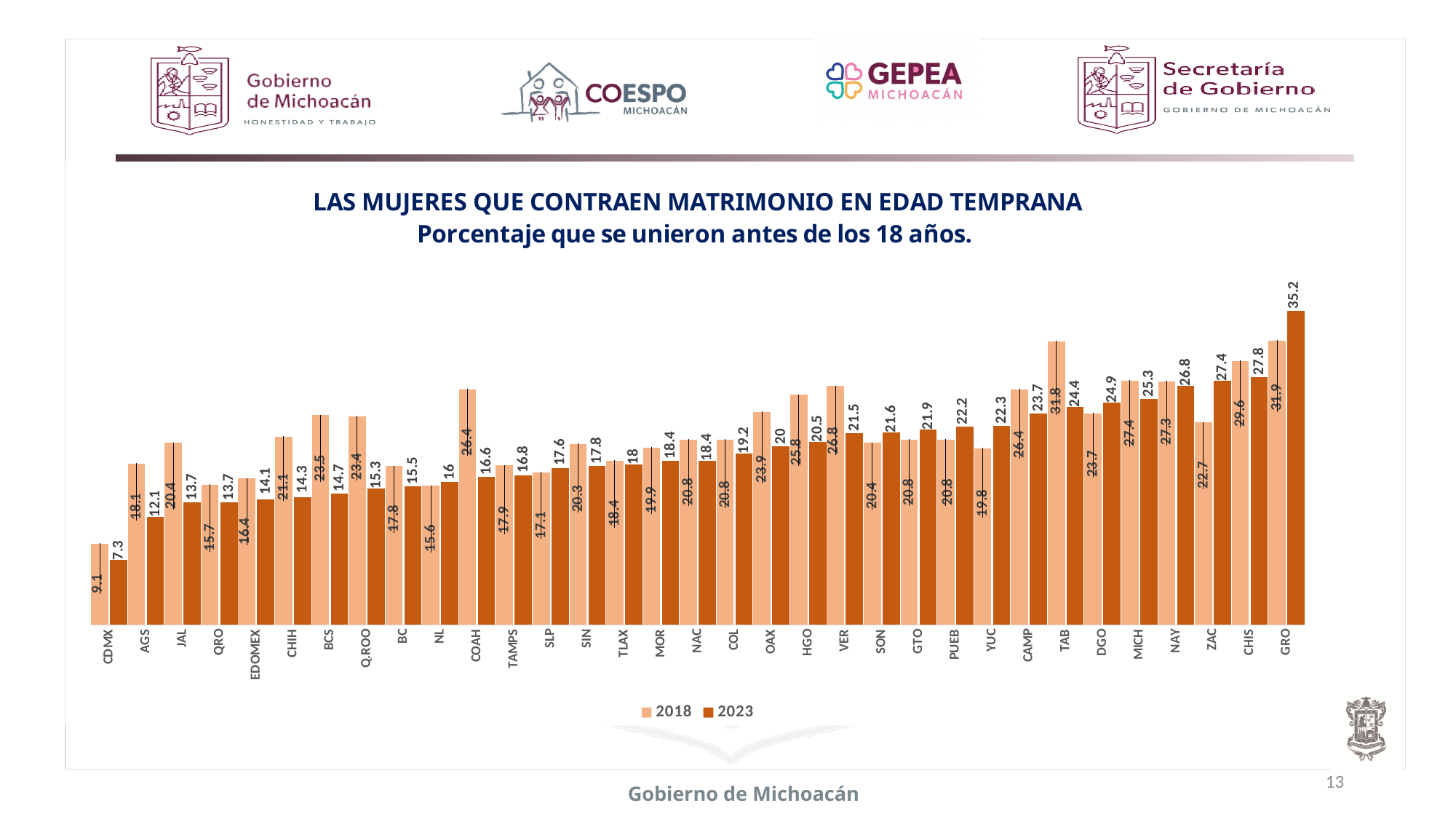
For GRO, what is the difference between the 2023 value and the 2018 value? 3.3 What kind of chart is shown on the slide? bar chart What is the 2023 value for MICH? 25.3 What is the 2023 value for GRO? 35.2 How many states (categories) are shown on the x axis? 33 How many series does the legend list? 2 Which state has the highest 2023 value? GRO What is the 2018 value for CDMX? 9.1 Which state has the lowest 2023 value? CDMX What is the 2018 value for TAB? 31.8 Which two series are listed in the legend? 2018 and 2023 For MICH, which is larger, the 2018 value or the 2023 value? 2018